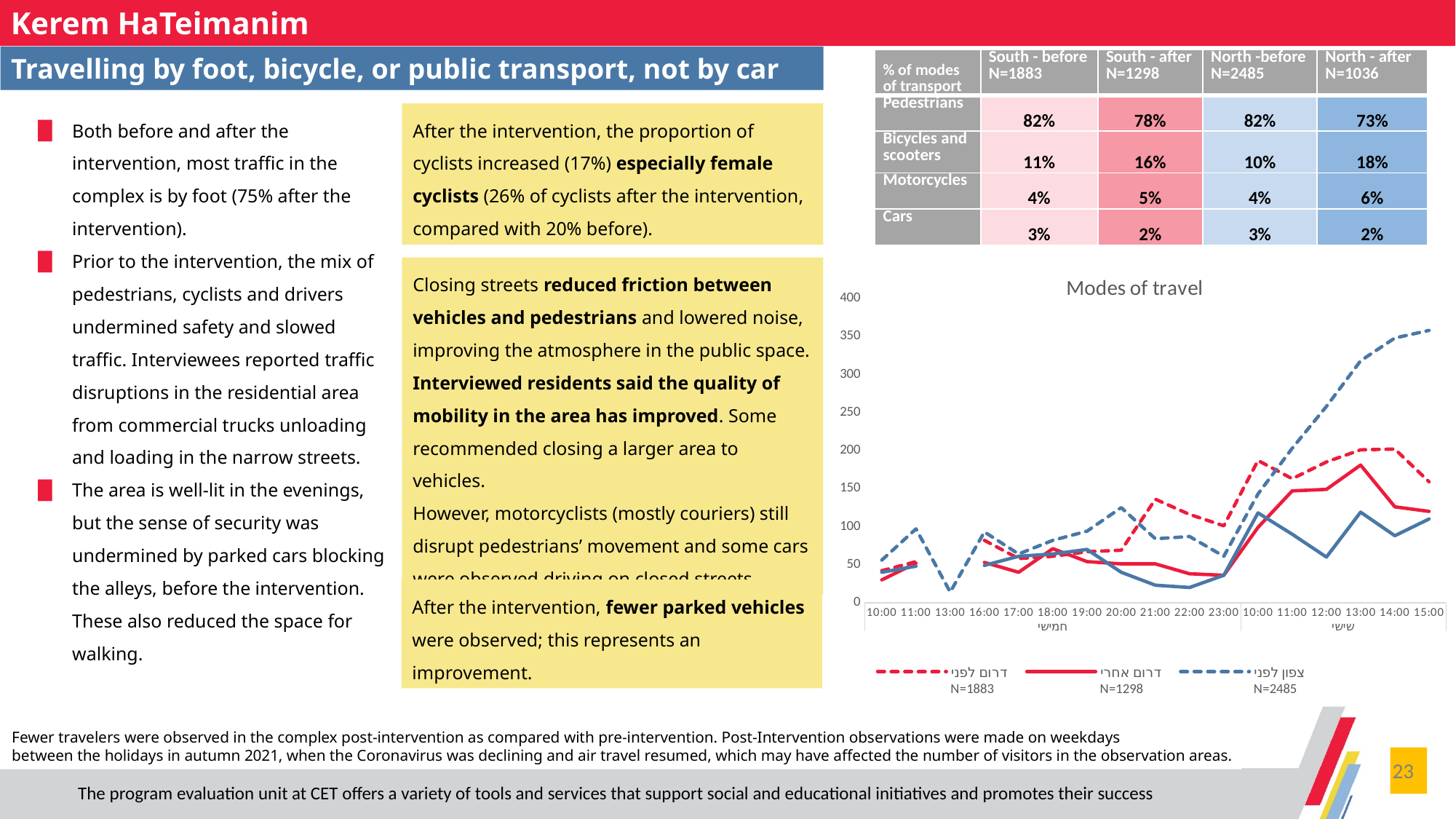
What is the title of the line chart on the slide? Modes of travel In the 'Modes of travel' chart, is the value for 'צפון לפני' at 15:00 on שישי greater or less than 300? greater How many series does the legend of the 'Modes of travel' chart list? 3 In the 'Modes of travel' chart, does the 'צפון לפני' series rise or fall from 10:00 to 15:00 on שישי? rise In the 'Modes of travel' chart, is the value for 'צפון לפני' at 13:00 on חמישי greater or less than 50? less In the 'Modes of travel' chart, which series reaches the highest value? צפון לפני In the 'Modes of travel' chart, is the value for 'דרום אחרי' at 22:00 on חמישי greater or less than 50? less In the 'Modes of travel' chart, what sample size (N) is shown in the legend for the series 'צפון לפני'? N=2485 In the 'Modes of travel' chart, at 15:00 on שישי, which is larger: 'צפון לפני' or 'דרום אחרי'? צפון לפני How many time points are shown on the x axis of the 'Modes of travel' chart in total? 17 What kind of chart is the 'Modes of travel' chart? line chart